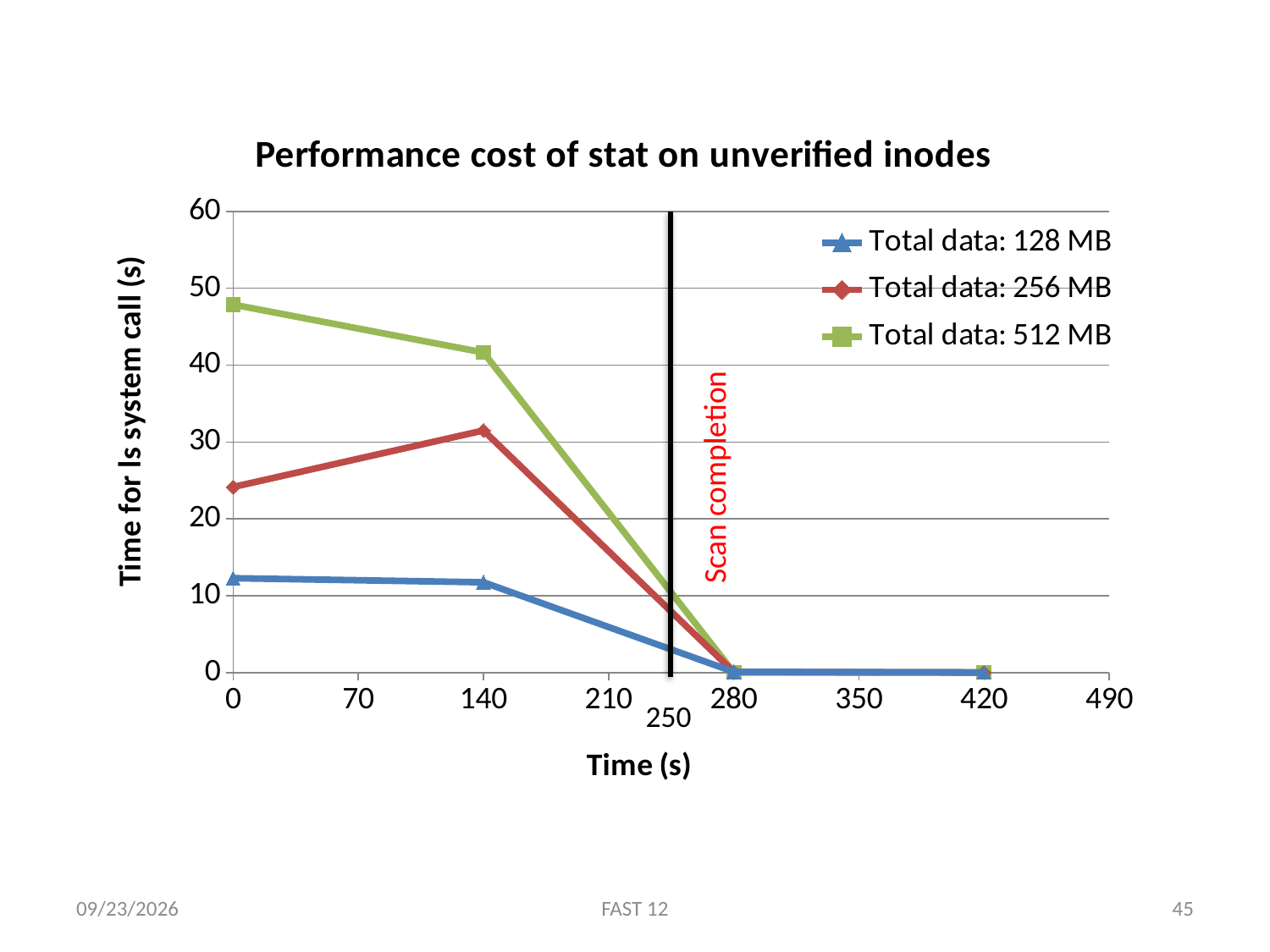
Which series has the lowest value at time 140? Total data: 128 MB Is the value for Total data: 256 MB at time 0 greater or less than 20? greater What is the title of the chart? Performance cost of stat on unverified inodes Which series has the highest value at time 0? Total data: 512 MB How many series does the legend list? 3 Does the Total data: 512 MB series rise or fall between time 0 and time 280? fall Is the value for Total data: 128 MB at time 140 greater or less than 20? less At time 140, which is larger: Total data: 256 MB or Total data: 128 MB? Total data: 256 MB At what time on the x axis is the vertical 'Scan completion' line drawn? 250 What kind of chart is shown on the slide? line chart Is the value for Total data: 512 MB at time 0 greater or less than 40? greater